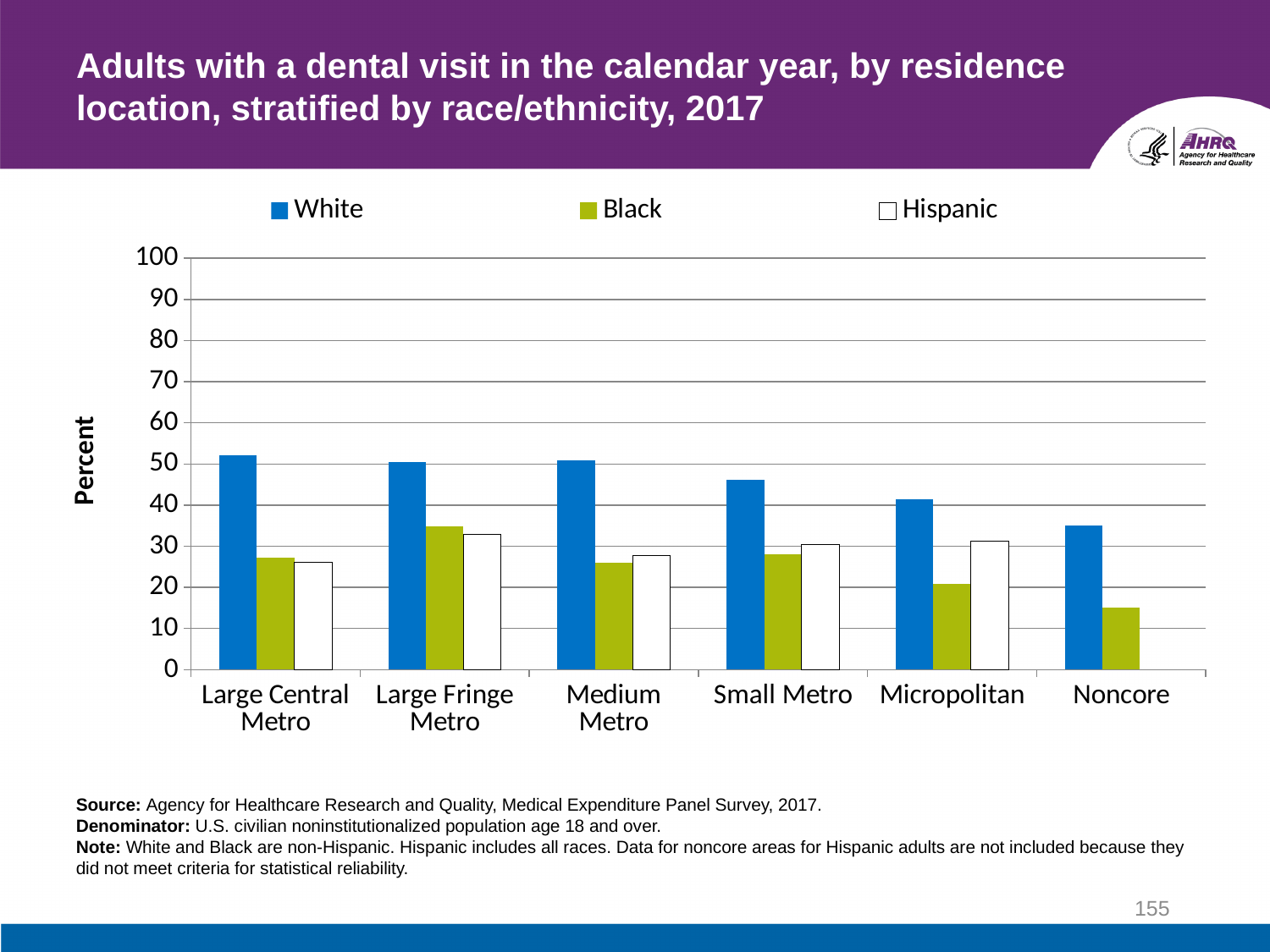
Which residence location has no bar for Hispanic adults? Noncore What kind of chart is shown on the slide? bar chart Which residence location has the highest value for White adults? Large Central Metro Which residence location has the highest value for Black adults? Large Fringe Metro Which residence location has the lowest value for Black adults? Noncore In Small Metro areas, which is larger: the value for Black adults or for Hispanic adults? Hispanic Is the value for White adults in Large Central Metro greater or less than 50? greater Is the value for Black adults in Noncore greater or less than 20? less How many residence location categories are shown on the x axis? 6 How many series does the legend list? 3 In Micropolitan areas, which is larger: the value for White adults or for Black adults? White